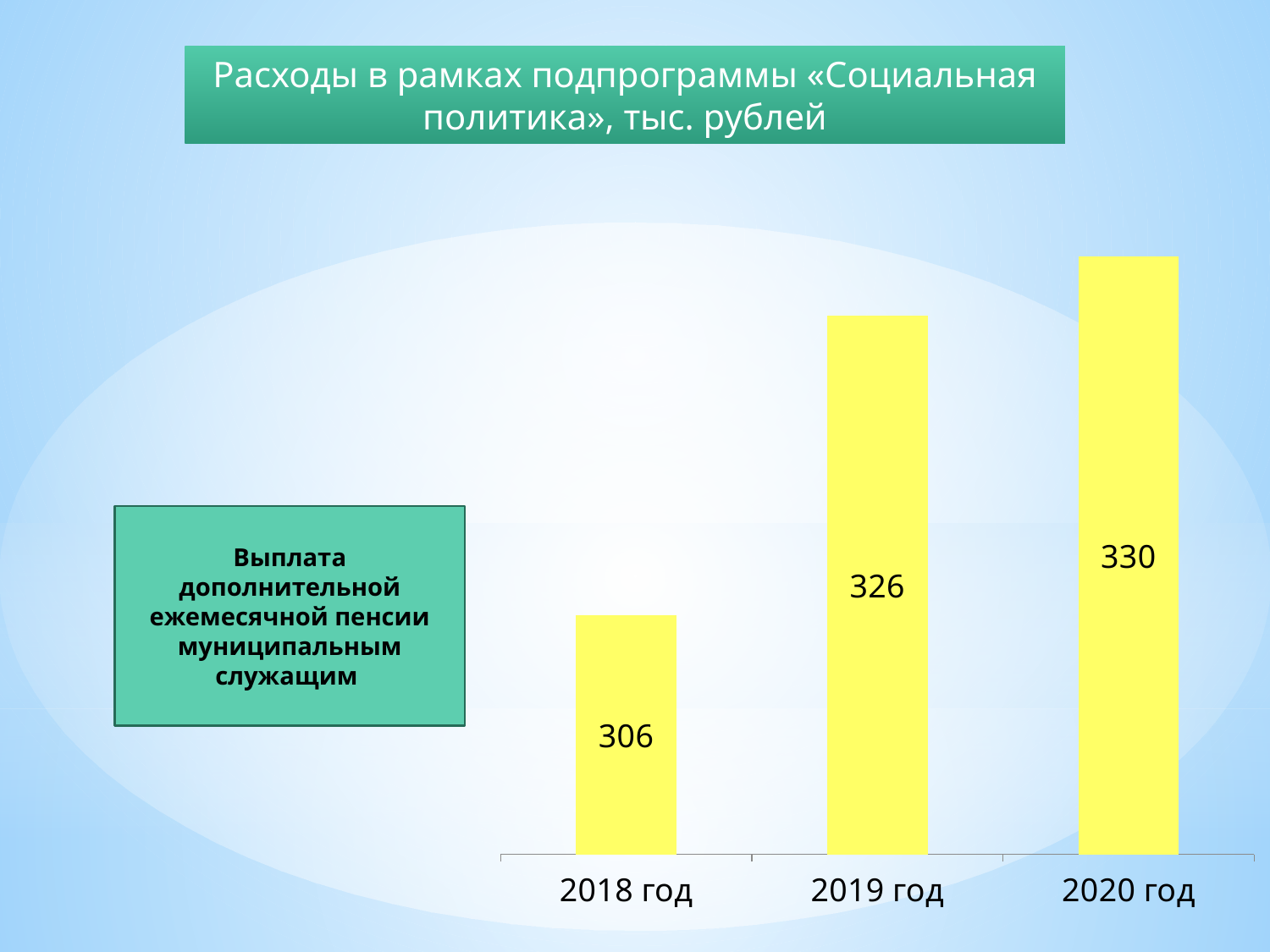
What is the value for 2019 год? 326 Do the values rise or fall from 2018 год to 2020 год? rise What kind of chart is shown on the slide? bar chart Which year has the lowest value? 2018 год What is the difference between the values for 2020 год and 2018 год? 24 What is the value for 2020 год? 330 Which is larger, the value for 2018 год or the value for 2019 год? 2019 год What is the difference between the values for 2019 год and 2018 год? 20 How many years are shown on the chart? 3 Which year has the highest value? 2020 год What colour are the bars on the chart? yellow What is the value for 2018 год? 306